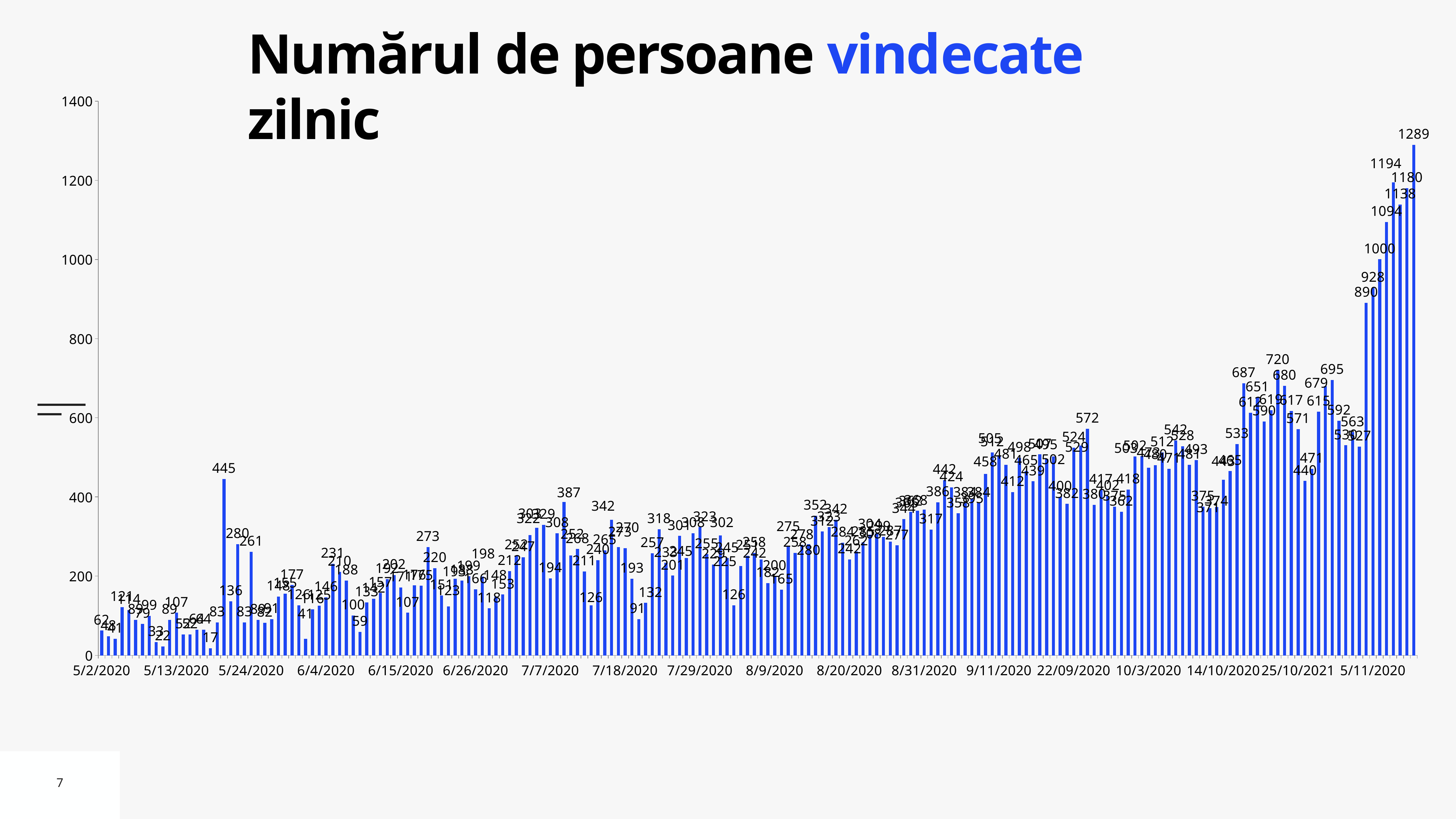
What is the highest value shown in the chart? 1289 What kind of chart is shown on the slide? bar chart Do the values generally rise or fall from left to right along the x axis? rise Which is larger, the value of the first bar at 5/2/2020 or the value of the last bar? the last bar What is the value of the first bar, at 5/2/2020? 62 What is the maximum value shown on the y axis? 1400 What is the difference between the highest value (1289) and the second highest value (1194)? 95 What is the difference between the bars labelled 1000 and 928? 72 What is the title of the chart? Numărul de persoane vindecate zilnic Is the value of the last bar greater or less than 1200? greater What is the lowest value shown in the chart? 17 What is the difference between the last bar (1289) and the first bar (62)? 1227